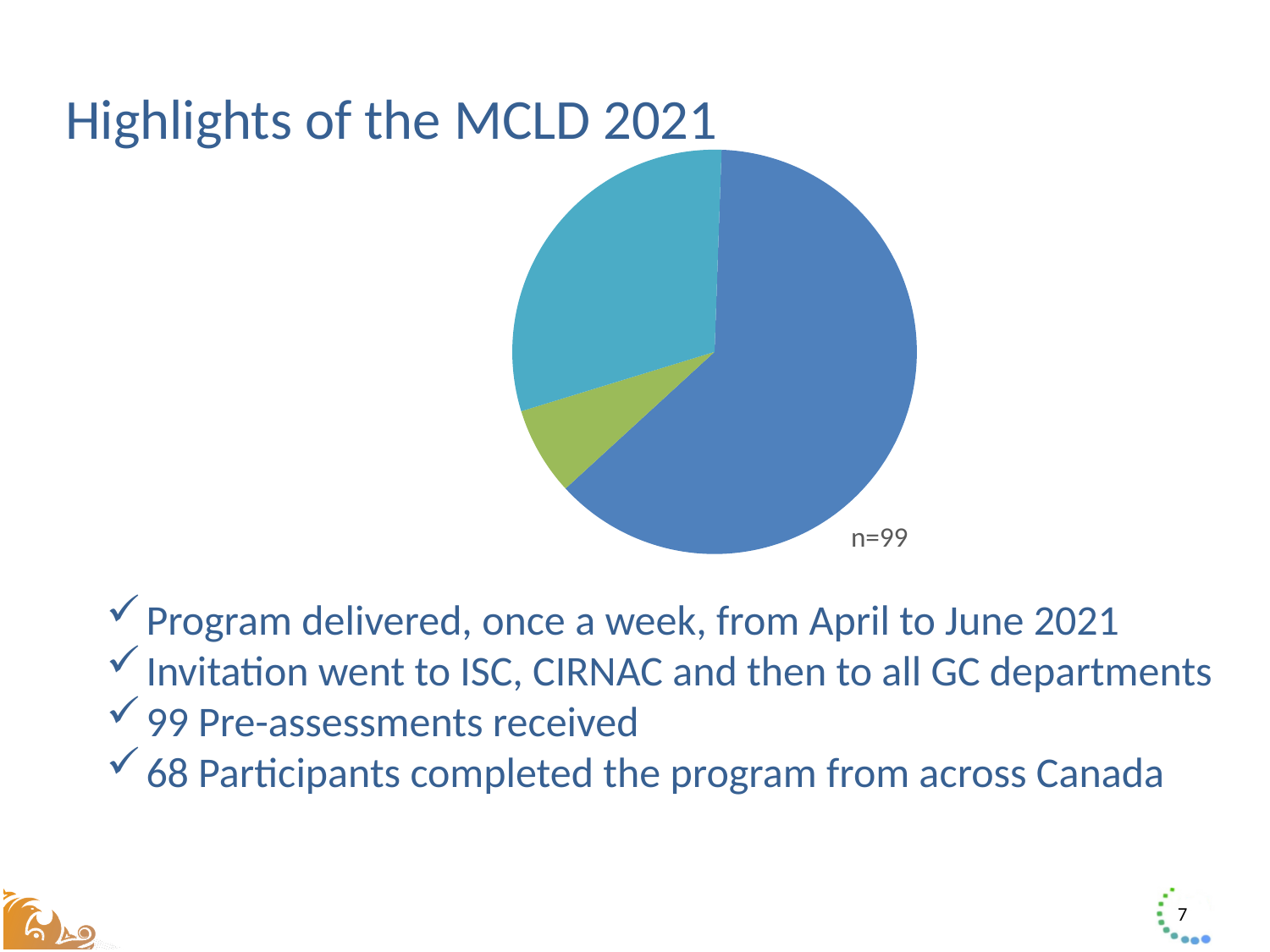
How many slices does the pie chart have? 3 Does the dark blue slice take up more or less than half of the pie chart? more What kind of chart is shown on the slide? pie chart Which colour slice is the largest in the pie chart? dark blue Which slice is larger in the pie chart, the dark blue slice or the light blue slice? dark blue What sample size is noted next to the pie chart? n=99 Does the pie chart include a legend? No Which slice is larger in the pie chart, the light blue slice or the green slice? light blue Which colour slice is the smallest in the pie chart? green